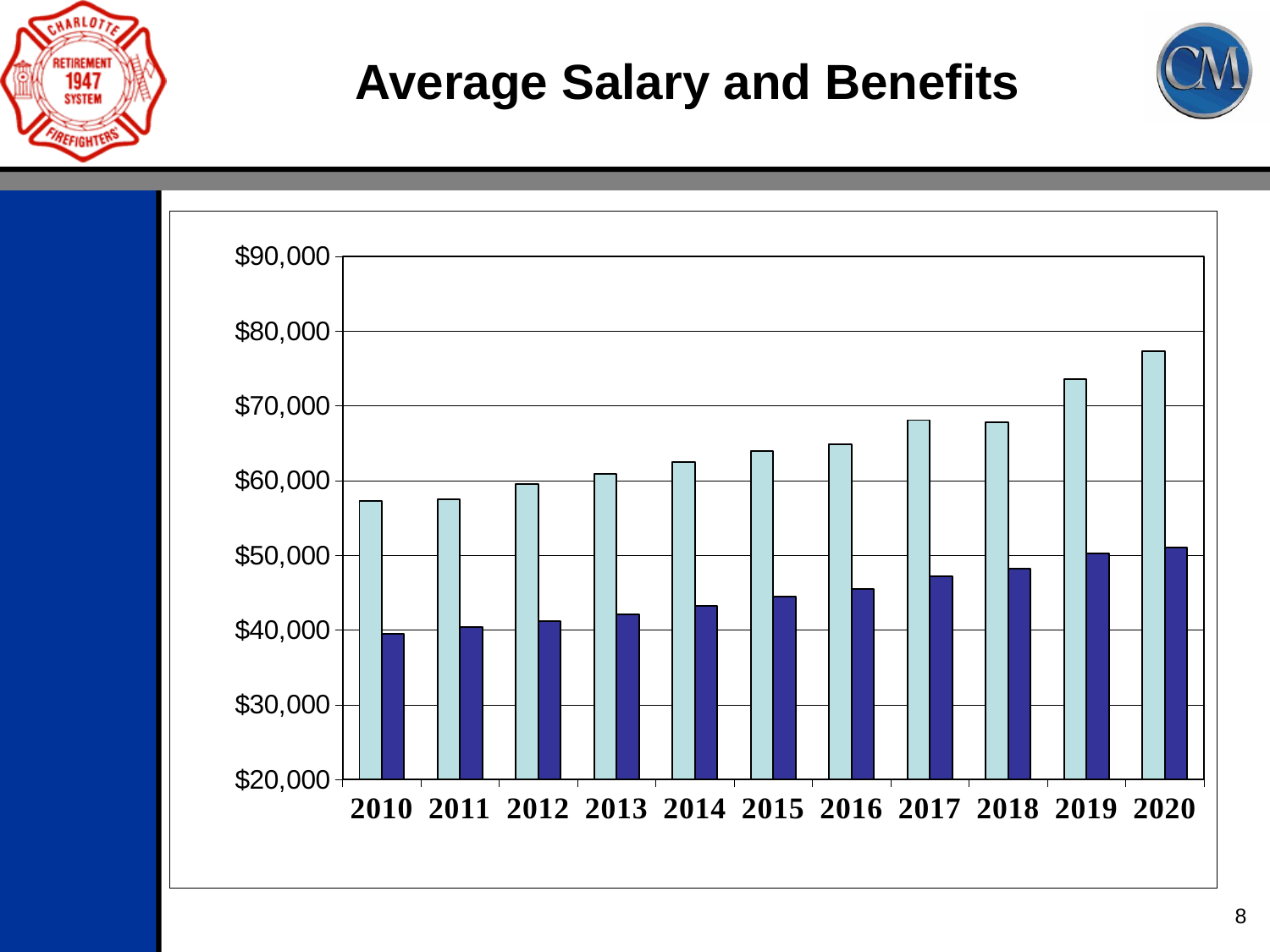
Which is larger, the dark blue bar for 2012 or the dark blue bar for 2016? 2016 Is the value of the dark blue bar for 2018 greater or less than $40,000? greater Is the value of the light blue bar for 2017 greater or less than $70,000? less Is the value of the dark blue bar for 2015 greater or less than $50,000? less Which is larger, the light blue bar for 2016 or the light blue bar for 2019? 2019 What is the title of the chart on the slide? Average Salary and Benefits How many years are shown along the x axis of the chart? 11 Do the dark blue bars generally rise or fall from 2010 to 2020? Rise In which year is the light blue bar the tallest? 2020 What kind of chart is shown on the slide? Bar chart